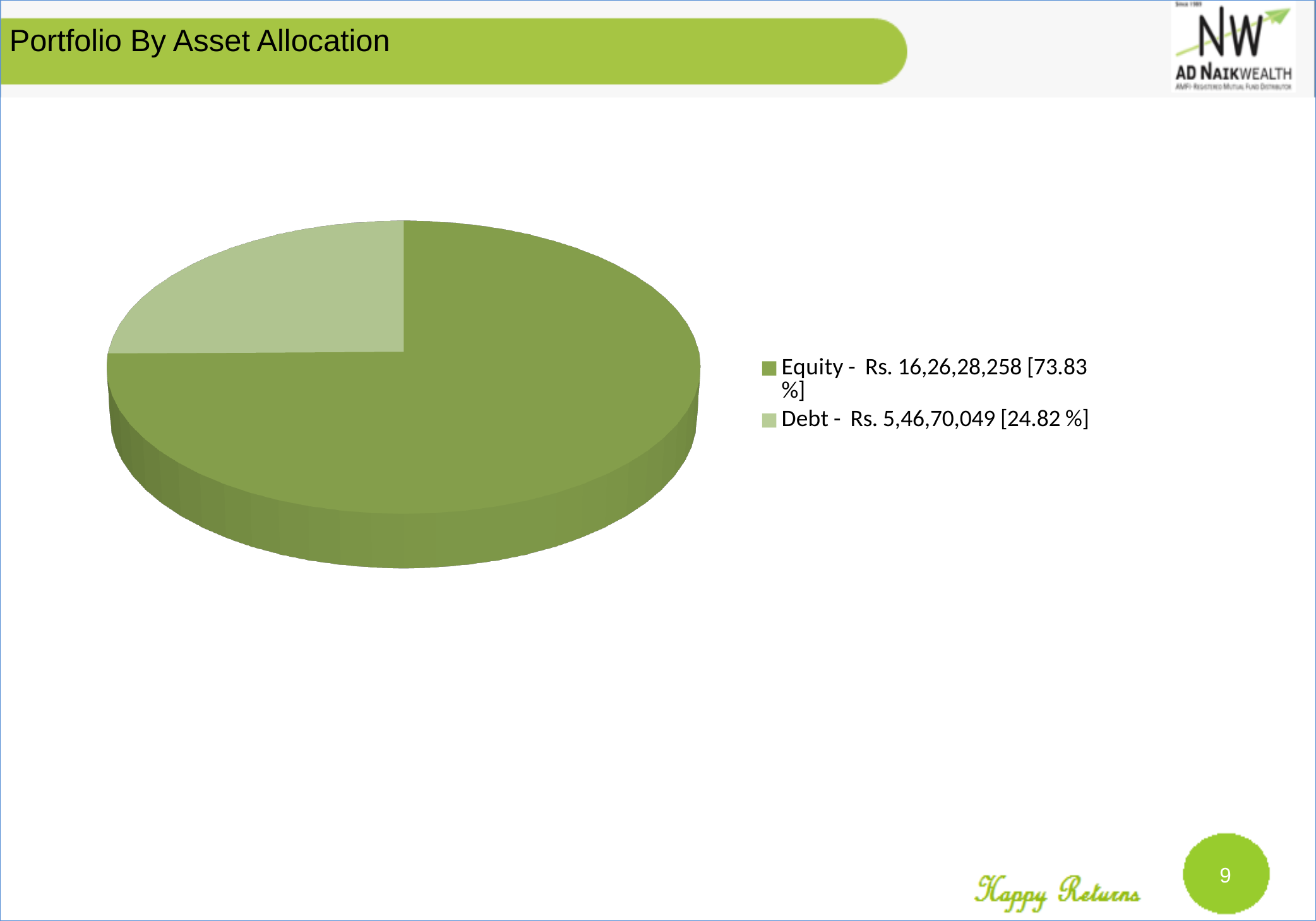
What kind of chart is shown on the slide? Pie chart How many slices does the pie chart have? 2 What share of the pie does Debt represent? 24.82 % What is the title of the slide containing the pie chart? Portfolio By Asset Allocation What is the value for Debt in the pie chart? Rs. 5,46,70,049 Which slice is shown in the lighter green colour? Debt What is the difference in percentage share between Equity and Debt? 49.01 % Which is larger, the Equity slice or the Debt slice? Equity Which asset class has the smallest slice of the pie? Debt What is the value for Equity in the pie chart? Rs. 16,26,28,258 Which asset class has the largest slice of the pie? Equity What share of the pie does Equity represent? 73.83 %